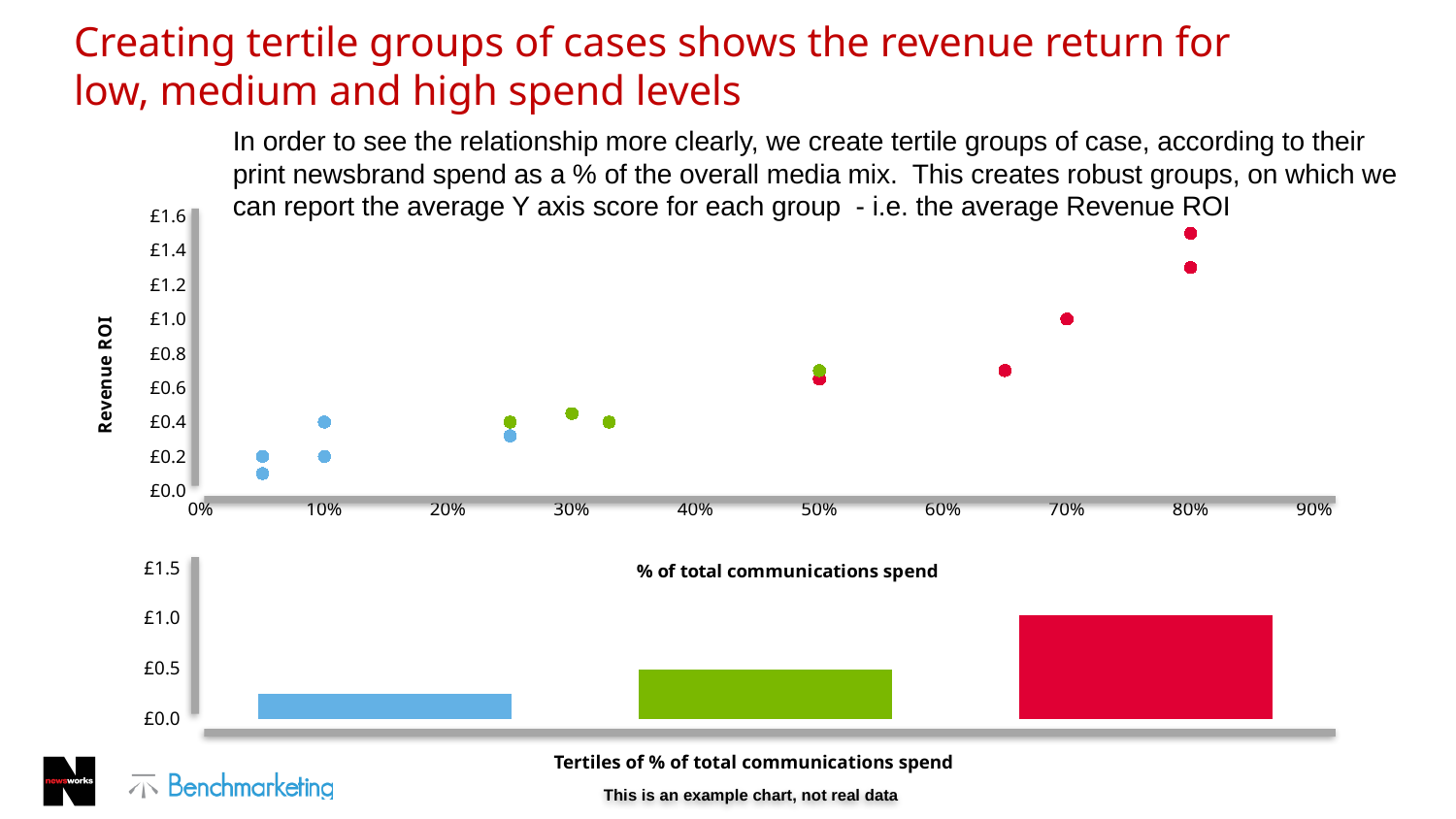
What is the x-axis title of the bottom chart? Tertiles of % of total communications spend In the bottom chart, which bar is the shortest? the blue bar (leftmost) In the bottom chart, how many bars are plotted? 3 In the bottom chart, is the green bar taller or shorter than the red bar? shorter In the bottom chart, is the value of the blue bar greater or less than £0.5? less In the top chart, do the Revenue ROI values generally rise or fall as % of total communications spend increases? rise What is the y-axis title of the top chart? Revenue ROI In the bottom chart, is the value of the red bar greater or less than £0.5? greater In the bottom chart, which bar is the tallest? the red bar (rightmost) What kind of chart is the top chart on the slide? scatter chart In the top chart, is the highest plotted point greater or less than £1.4? greater What kind of chart is the bottom chart on the slide? bar chart